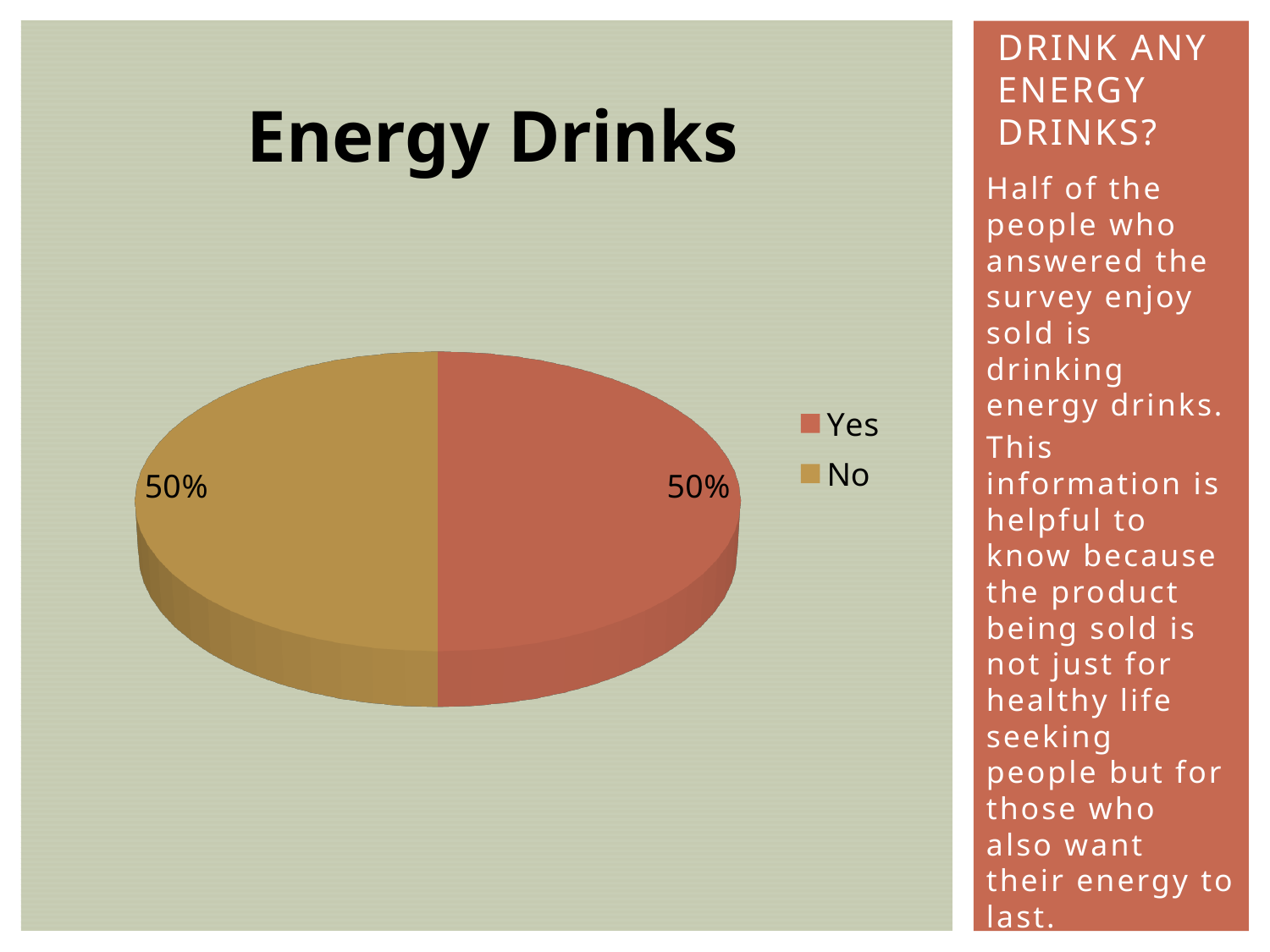
What is the total of the Yes and No percentages? 100% Which colour represents the Yes slice in the legend? red What share of the pie does the Yes slice represent? 50% What kind of chart is shown on the slide? pie chart How many entries does the legend list? 2 What is the difference between the Yes and No percentages? 0% How many slices does the pie chart have? 2 What share of the pie does the No slice represent? 50% What is the title of the chart? Energy Drinks